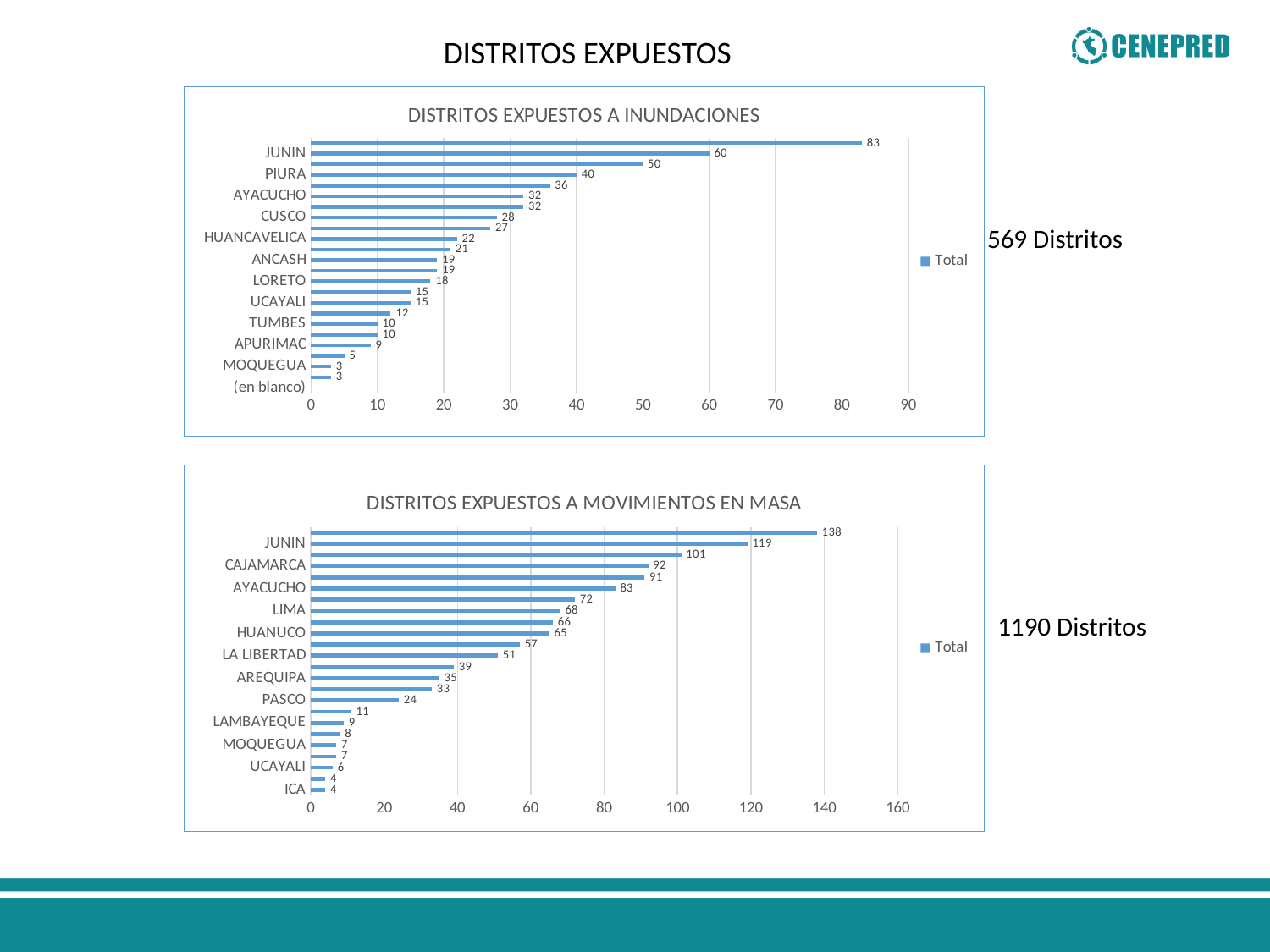
In the 'DISTRITOS EXPUESTOS A INUNDACIONES' chart, what is the difference between the two longest bars (83 and 60)? 23 In the 'DISTRITOS EXPUESTOS A INUNDACIONES' chart, what is the value of the longest bar? 83 How many series does the legend of the 'DISTRITOS EXPUESTOS A INUNDACIONES' chart list? 1 What type of chart is 'DISTRITOS EXPUESTOS A INUNDACIONES'? bar chart In the 'DISTRITOS EXPUESTOS A MOVIMIENTOS EN MASA' chart, is the longest bar greater or less than 120? greater What total number of districts is written next to the 'DISTRITOS EXPUESTOS A INUNDACIONES' chart? 569 Distritos In the 'DISTRITOS EXPUESTOS A MOVIMIENTOS EN MASA' chart, what is the value of the longest bar? 138 What is the legend entry in the 'DISTRITOS EXPUESTOS A INUNDACIONES' chart? Total What is the highest tick value on the x axis of the 'DISTRITOS EXPUESTOS A MOVIMIENTOS EN MASA' chart? 160 In the 'DISTRITOS EXPUESTOS A MOVIMIENTOS EN MASA' chart, what is the value of the shortest bar? 4 In the 'DISTRITOS EXPUESTOS A INUNDACIONES' chart, what is the value of the shortest labelled bar? 3 In the 'DISTRITOS EXPUESTOS A MOVIMIENTOS EN MASA' chart, what is the difference between the two longest bars (138 and 119)? 19